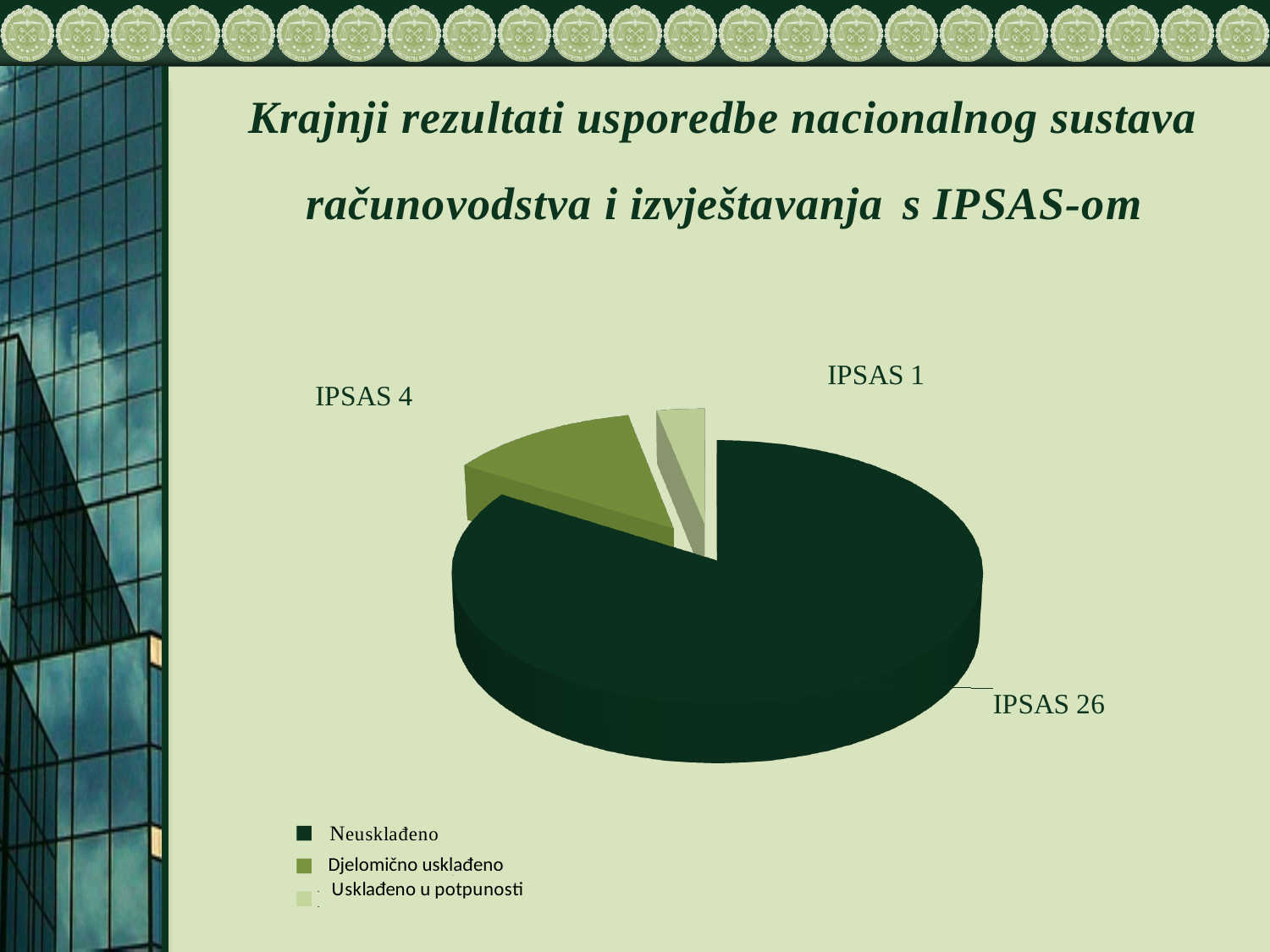
Which slice is larger: Djelomično usklađeno or Usklađeno u potpunosti? Djelomično usklađeno What kind of chart is shown on the slide? pie chart How many IPSAS are labelled for the Neusklađeno slice? 26 How many IPSAS are labelled for the Usklađeno u potpunosti slice? 1 How many IPSAS are labelled for the Djelomično usklađeno slice? 4 Which category has the largest slice of the pie? Neusklađeno What is the difference between the number of IPSAS in the Neusklađeno slice and the Djelomično usklađeno slice? 22 Which legend entry is shown in the darkest green colour? Neusklađeno How many entries does the legend list? 3 What is the difference between the number of IPSAS in the Djelomično usklađeno slice and the Usklađeno u potpunosti slice? 3 Which category has the smallest slice of the pie? Usklađeno u potpunosti How many slices does the pie chart have? 3